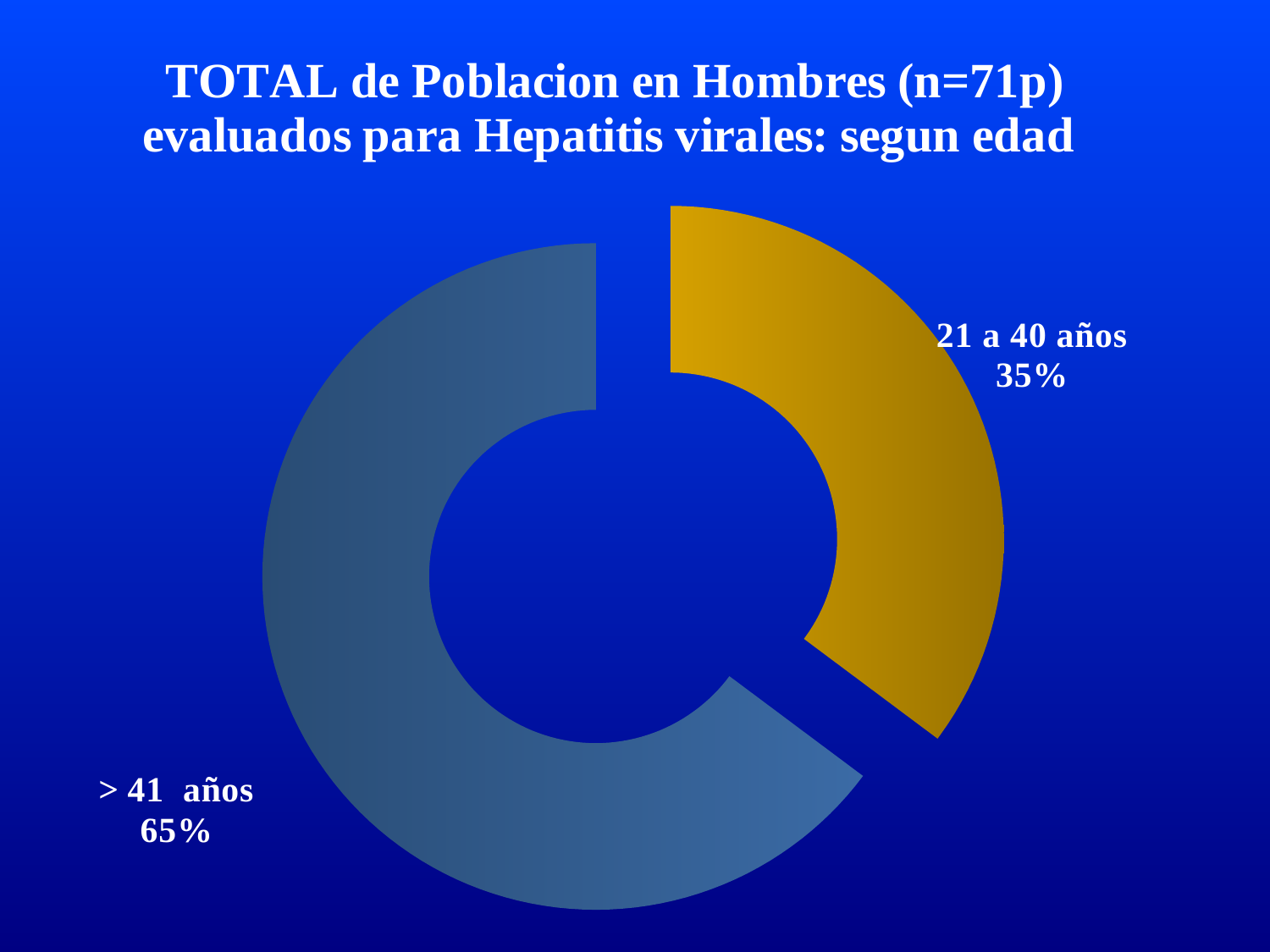
Which age group has the smallest share of the chart? 21 a 40 años What is the total of the two shares shown in the chart? 100% Which age group has the largest share of the chart? > 41 años What share of the men evaluated are aged 21 a 40 años? 35% What is the difference in percentage points between the > 41 años and 21 a 40 años shares? 30% What share of the men evaluated are aged > 41 años? 65% How many age categories are shown in the chart? 2 What kind of chart is shown on the slide? Doughnut (pie) chart Which is larger, the share for 21 a 40 años or the share for > 41 años? > 41 años What is the sample size (n) stated in the chart title? 71 What colour is the segment for 21 a 40 años? Gold/orange